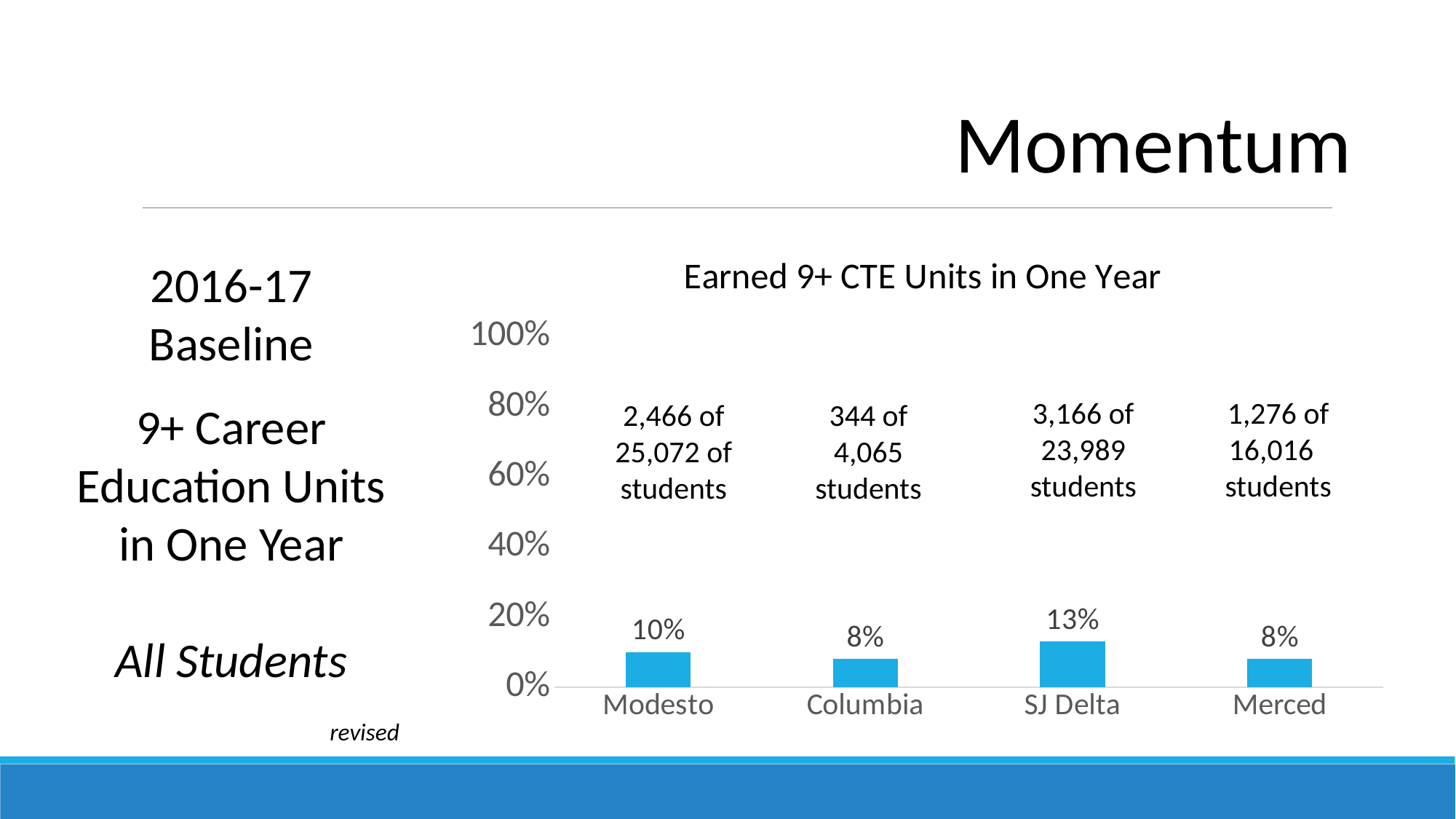
What is the title of the chart? Earned 9+ CTE Units in One Year How many students at Columbia earned 9+ CTE units, according to the annotation above the bar? 344 of 4,065 students What is the highest value shown on the y axis? 100% What kind of chart is shown on the slide? bar chart What is the value for Merced? 8% Is the value for SJ Delta greater or less than 20%? less Which college has the highest percentage of students who earned 9+ CTE units in one year? SJ Delta Which is larger, the value for Modesto or the value for Columbia? Modesto What is the value for Modesto? 10% What is the difference between the values for SJ Delta and Modesto? 3% How many colleges are shown on the x axis? 4 What is the value for SJ Delta? 13%